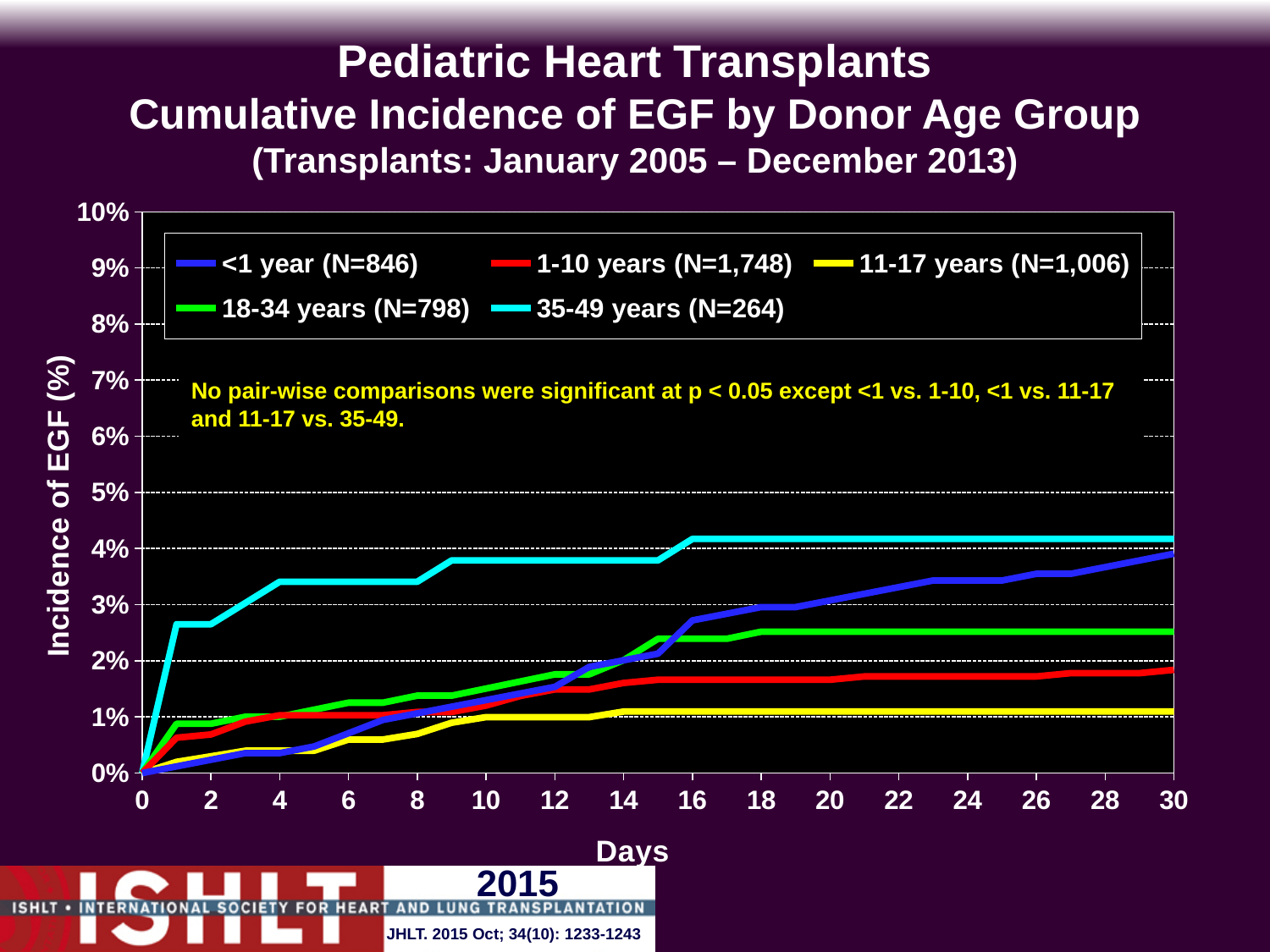
How many donor age groups does the legend list? 5 What kind of chart is shown on the slide? line chart Which donor age group has the lowest cumulative incidence of EGF at day 30? 11-17 years Is the incidence of EGF for the 18-34 years group at day 30 greater or less than 2%? greater Which donor age group has the highest cumulative incidence of EGF at day 30? 35-49 years Is the incidence of EGF for the 11-17 years group at day 30 greater or less than 2%? less Is the incidence of EGF for the <1 year group at day 30 greater or less than 3%? greater At day 30, which group has the higher incidence of EGF: 18-34 years or 1-10 years? 18-34 years What is the N for the 1-10 years donor age group shown in the legend? 1,748 At day 10, which group has the higher incidence of EGF: 35-49 years or <1 year? 35-49 years Do the cumulative incidence curves rise or fall as days increase? rise